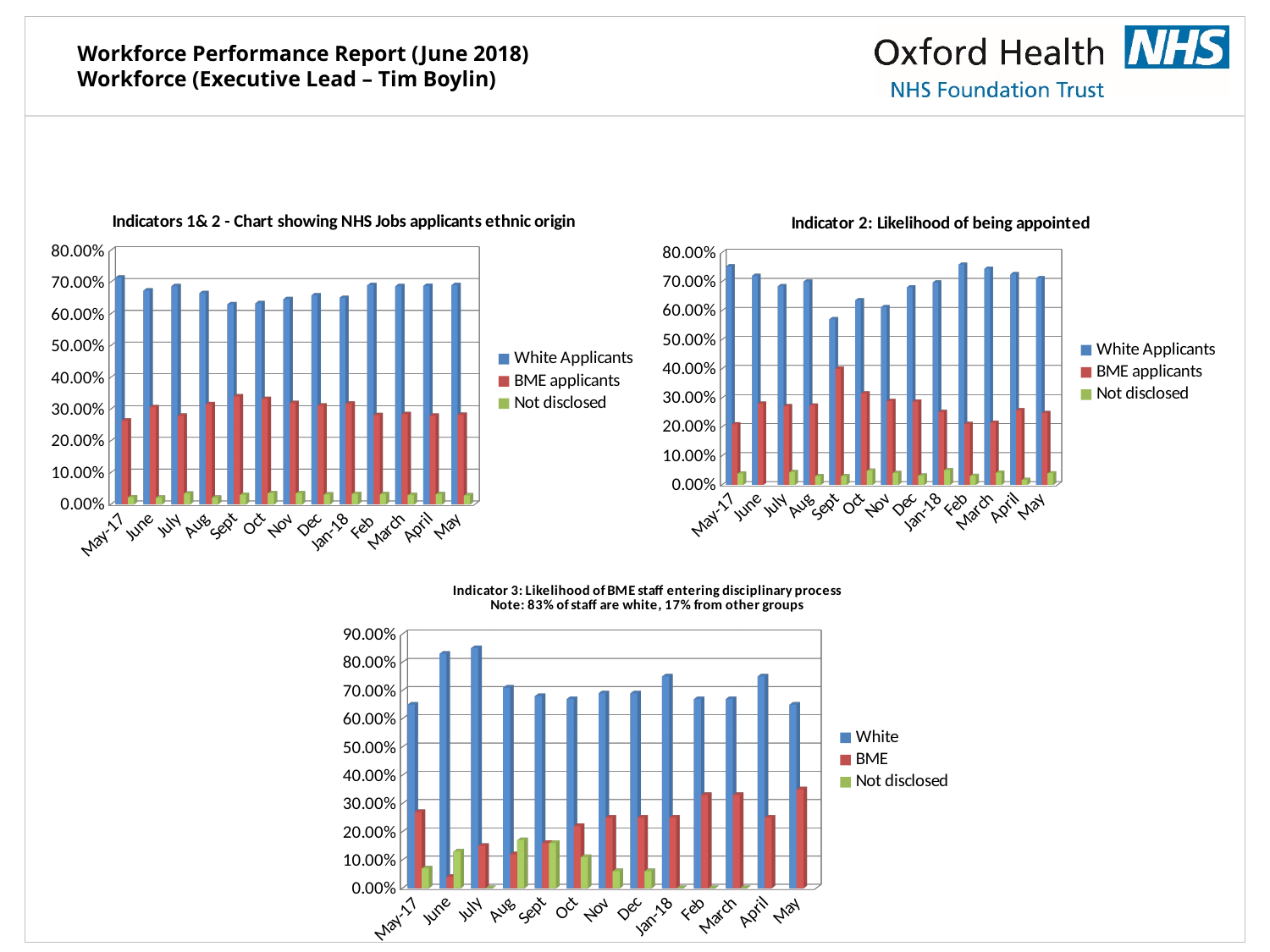
In the chart 'Indicators 1& 2 - Chart showing NHS Jobs applicants ethnic origin', which month has the highest value for White Applicants? May-17 How many months are shown on the x axis of the chart 'Indicator 3: Likelihood of BME staff entering disciplinary process'? 13 In the chart 'Indicator 3: Likelihood of BME staff entering disciplinary process', which is larger, the BME value for May-17 or for June? May-17 In the chart 'Indicator 3: Likelihood of BME staff entering disciplinary process', which is larger, the White value for June or for May-17? June In the chart 'Indicator 2: Likelihood of being appointed', is the value for White Applicants in Sept greater or less than 60.00%? less In the chart 'Indicator 2: Likelihood of being appointed', is the value for BME applicants in Sept greater or less than 30.00%? greater In the chart 'Indicator 3: Likelihood of BME staff entering disciplinary process', is the value for White in July greater or less than 80.00%? greater What kind of chart is 'Indicator 2: Likelihood of being appointed'? bar chart In the chart 'Indicator 2: Likelihood of being appointed', which month has the lowest value for White Applicants? Sept What are the three legend entries in the chart 'Indicator 3: Likelihood of BME staff entering disciplinary process'? White, BME, Not disclosed In the chart 'Indicator 2: Likelihood of being appointed', which month has the highest value for BME applicants? Sept How many series does the legend list in the chart 'Indicators 1& 2 - Chart showing NHS Jobs applicants ethnic origin'? 3